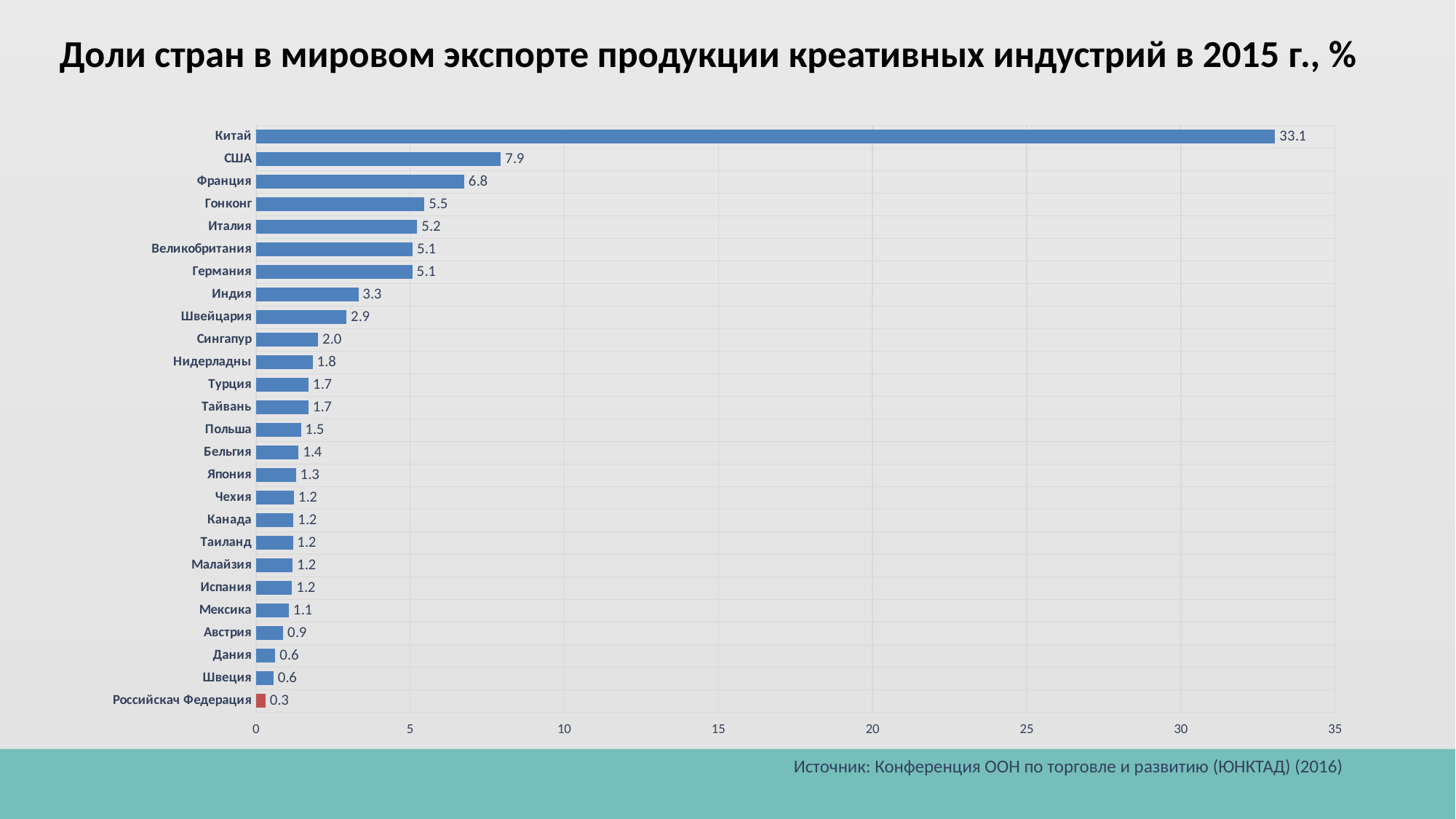
How many countries are shown in the chart? 26 What is the value for Китай? 33.1 What is the difference between the values for Франция and Гонконг? 1.3 What is the value for Индия? 3.3 What kind of chart is shown on the slide? bar chart What is the difference between the values for Китай and США? 25.2 Is the value for США greater or less than 5? greater Which country has the lowest value? Российскач Федерация Which country has the highest value? Китай Which bar is shown in a different colour (red) from the others? Российскач Федерация Which is larger, the value for Швейцария or the value for Сингапур? Швейцария What is the value for Российскач Федерация? 0.3